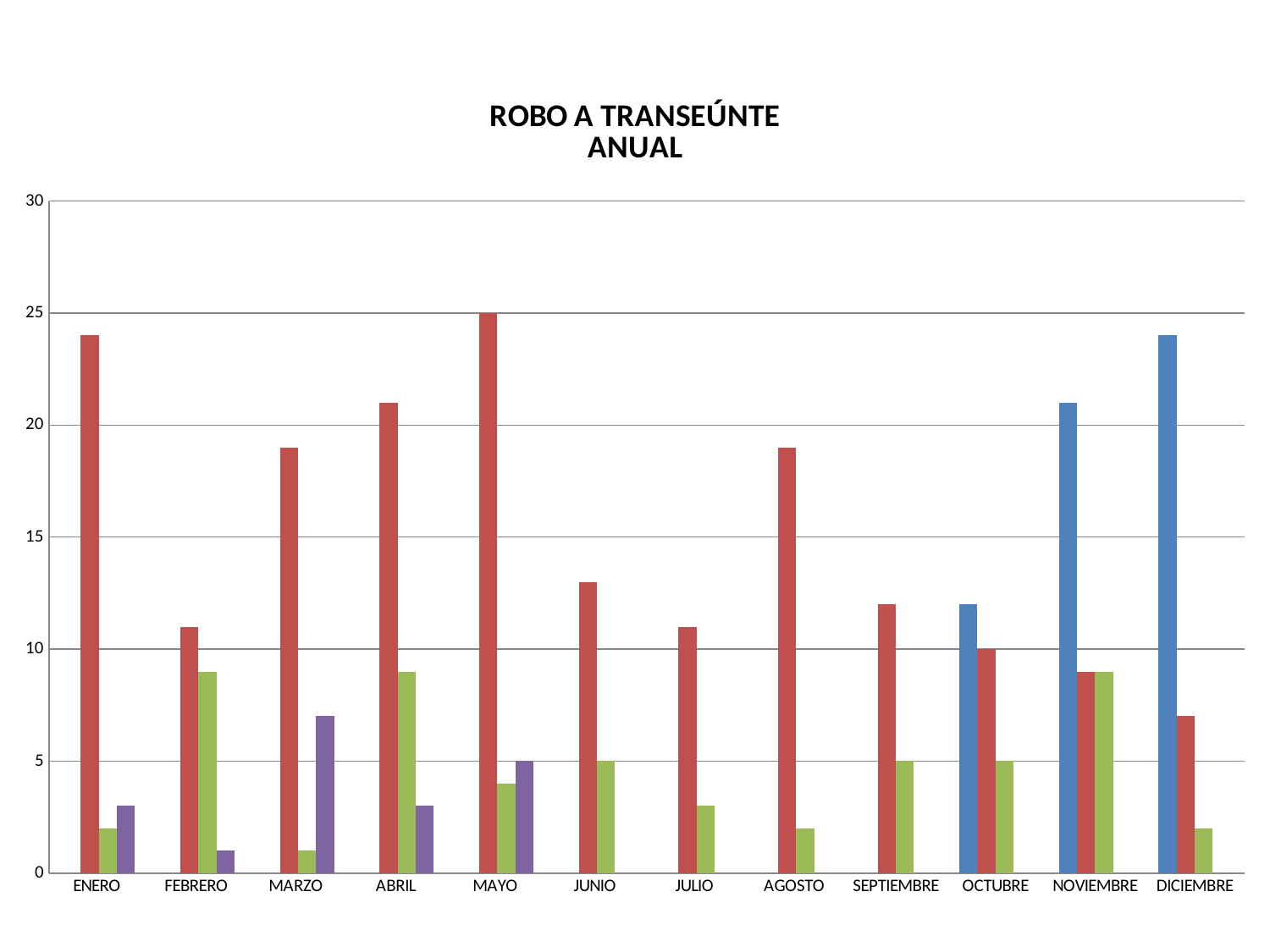
What is the value of the red bar for MAYO? 25 Is the value of the purple bar for MARZO greater or less than 5? greater Is the value of the red bar for ENERO greater or less than 20? greater What kind of chart is shown on the slide? bar chart What is the difference between the red bar for MAYO and the red bar for OCTUBRE? 15 Which is larger, the red bar for ENERO or the red bar for FEBRERO? ENERO What is the value of the red bar for OCTUBRE? 10 Is the value of the green bar for FEBRERO greater or less than 10? less What is the title of the chart? ROBO A TRANSEÚNTE ANUAL What is the value of the green bar for JUNIO? 5 Do the blue bars rise or fall from OCTUBRE to DICIEMBRE? rise How many months are shown on the x axis of the chart? 12